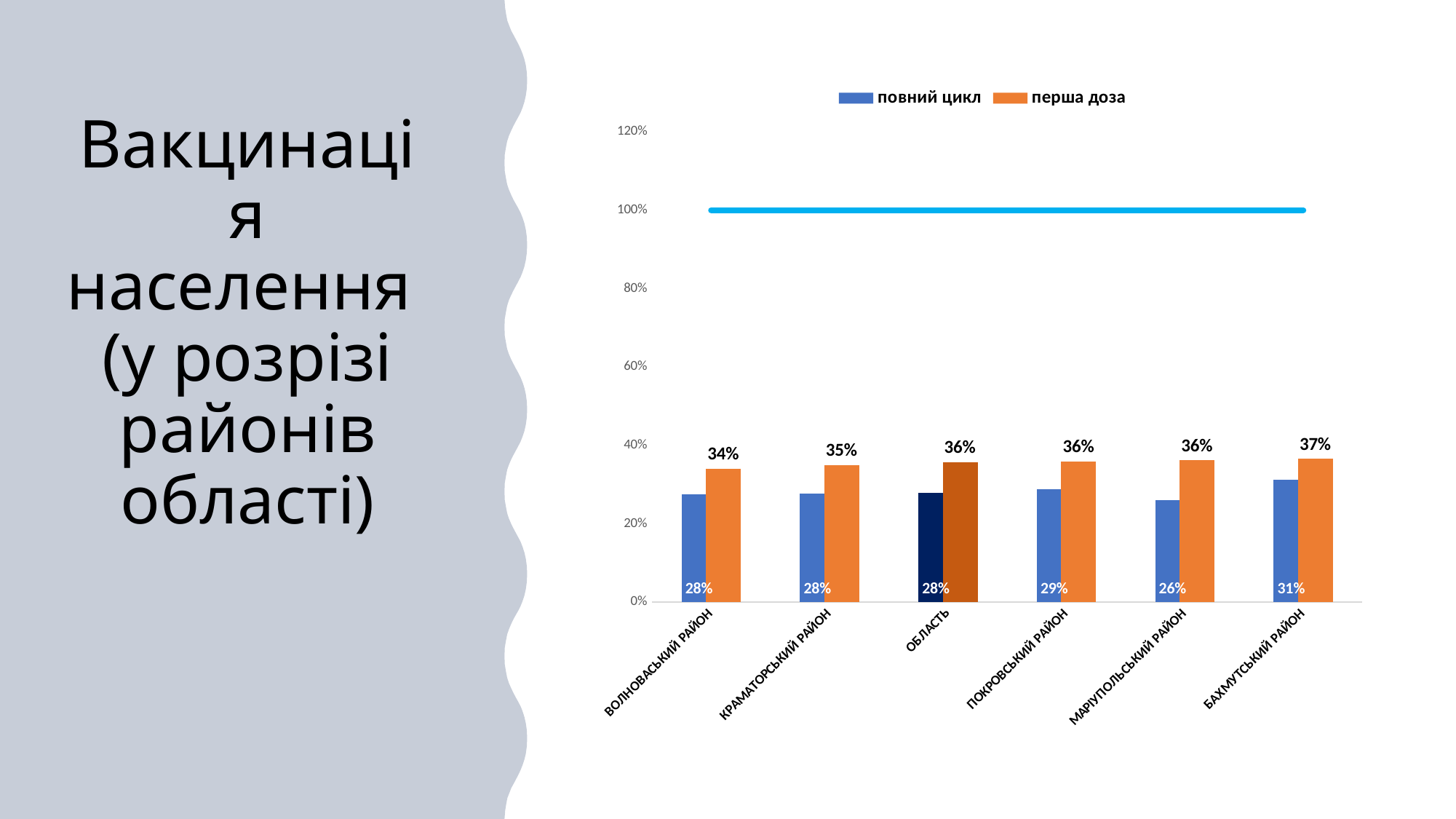
How many series does the legend list? 2 Do the "перша доза" values rise or fall from left to right along the x axis? rise Which category has the lowest value for "повний цикл"? Маріупольський район What is the difference between "перша доза" and "повний цикл" for Бахмутський район? 6% How many categories are shown on the x axis? 6 What type of chart is shown on the slide? bar and line chart What is the value of "повний цикл" for Область? 28% What is the value of "повний цикл" for Маріупольський район? 26% What are the two entries in the chart legend? повний цикл, перша доза Which category has the highest value for "перша доза"? Бахмутський район What is the value of "перша доза" for Волноваський район? 34% Which is larger: "повний цикл" for Бахмутський район or "повний цикл" for Покровський район? Бахмутський район